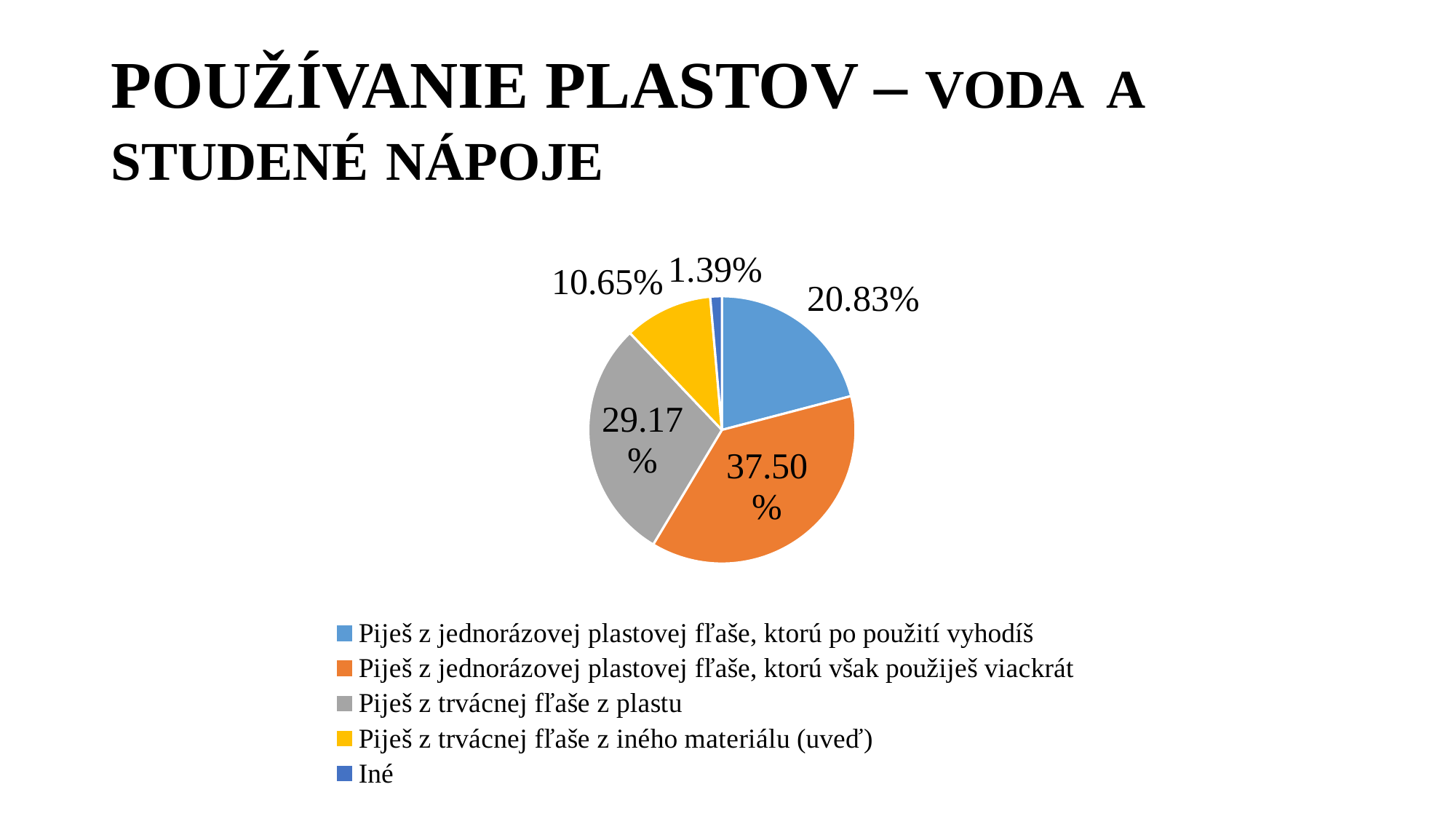
Which category has the smallest slice of the pie? Iné What is the difference between the shares for 'Piješ z jednorázovej plastovej fľaše, ktorú však použiješ viackrát' and 'Piješ z trvácnej fľaše z plastu'? 8.33% What share of the pie is 'Piješ z trvácnej fľaše z iného materiálu (uveď)'? 10.65% What kind of chart is shown on the slide? pie chart What share of the pie is 'Iné'? 1.39% Which category has the largest slice of the pie? Piješ z jednorázovej plastovej fľaše, ktorú však použiješ viackrát Which is larger: the share for 'Piješ z trvácnej fľaše z plastu' or for 'Piješ z jednorázovej plastovej fľaše, ktorú po použití vyhodíš'? Piješ z trvácnej fľaše z plastu What share of the pie is 'Piješ z jednorázovej plastovej fľaše, ktorú však použiješ viackrát'? 37.50% What share of the pie is 'Piješ z jednorázovej plastovej fľaše, ktorú po použití vyhodíš'? 20.83% What colour is the slice for 'Piješ z trvácnej fľaše z iného materiálu (uveď)'? yellow How many categories does the pie chart have? 5 What share of the pie is 'Piješ z trvácnej fľaše z plastu'? 29.17%